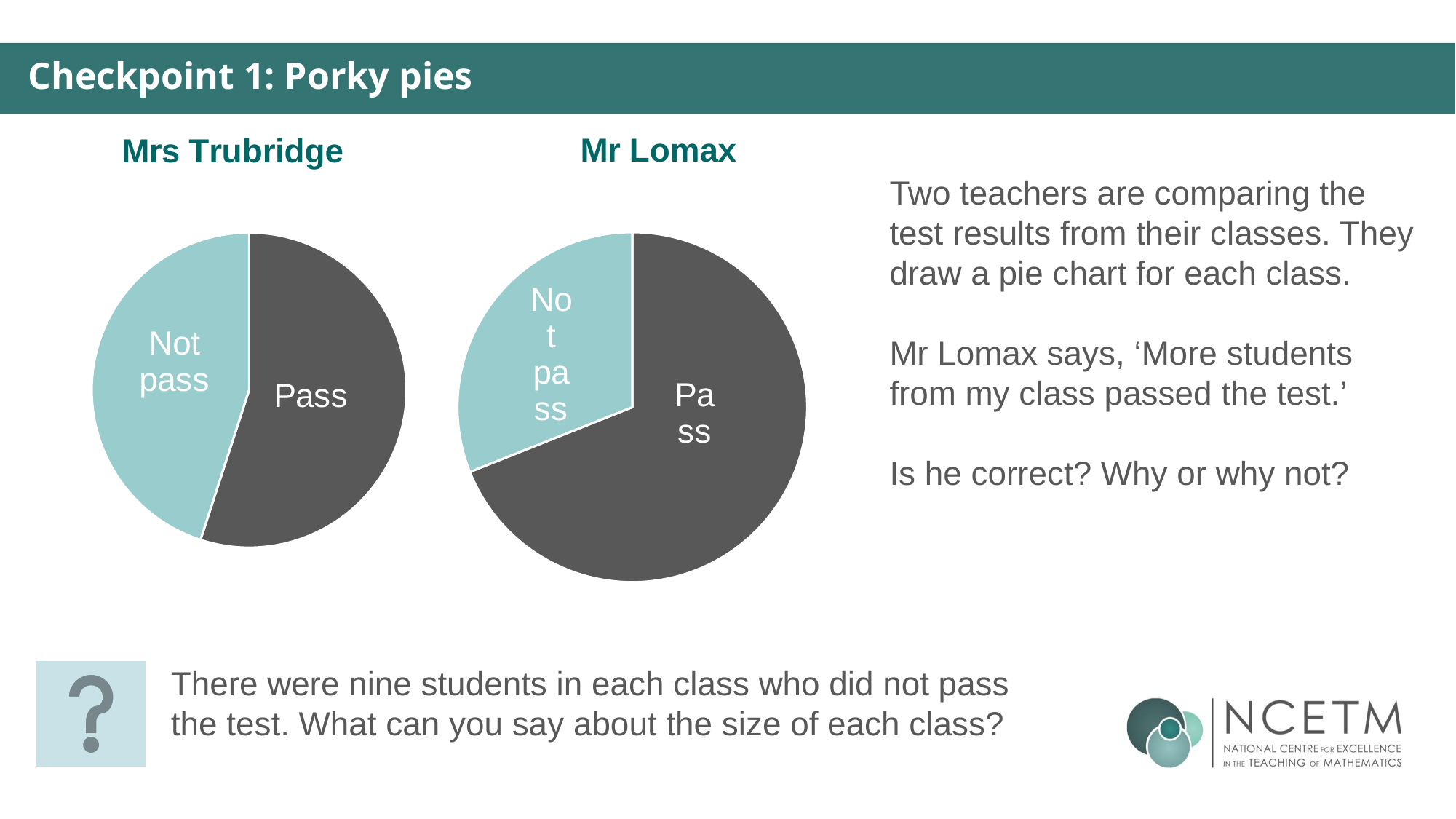
In the Mrs Trubridge pie chart, how many slices are there? 2 What kind of chart is shown under the heading Mrs Trubridge? Pie chart Comparing the two pie charts, which teacher's chart shows a larger share for Pass? Mr Lomax In the Mr Lomax pie chart, which slice is larger, Pass or Not pass? Pass In both pie charts, what colour is the Not pass slice? Light teal In the Mr Lomax pie chart, how many slices are there? 2 In the Mr Lomax pie chart, which slice is the smallest? Not pass In the Mrs Trubridge pie chart, which slice is the smallest? Not pass In the Mrs Trubridge pie chart, which slice is larger, Pass or Not pass? Pass In the Mr Lomax pie chart, which slice is the largest? Pass What kind of chart is shown under the heading Mr Lomax? Pie chart What is the heading above the left pie chart? Mrs Trubridge